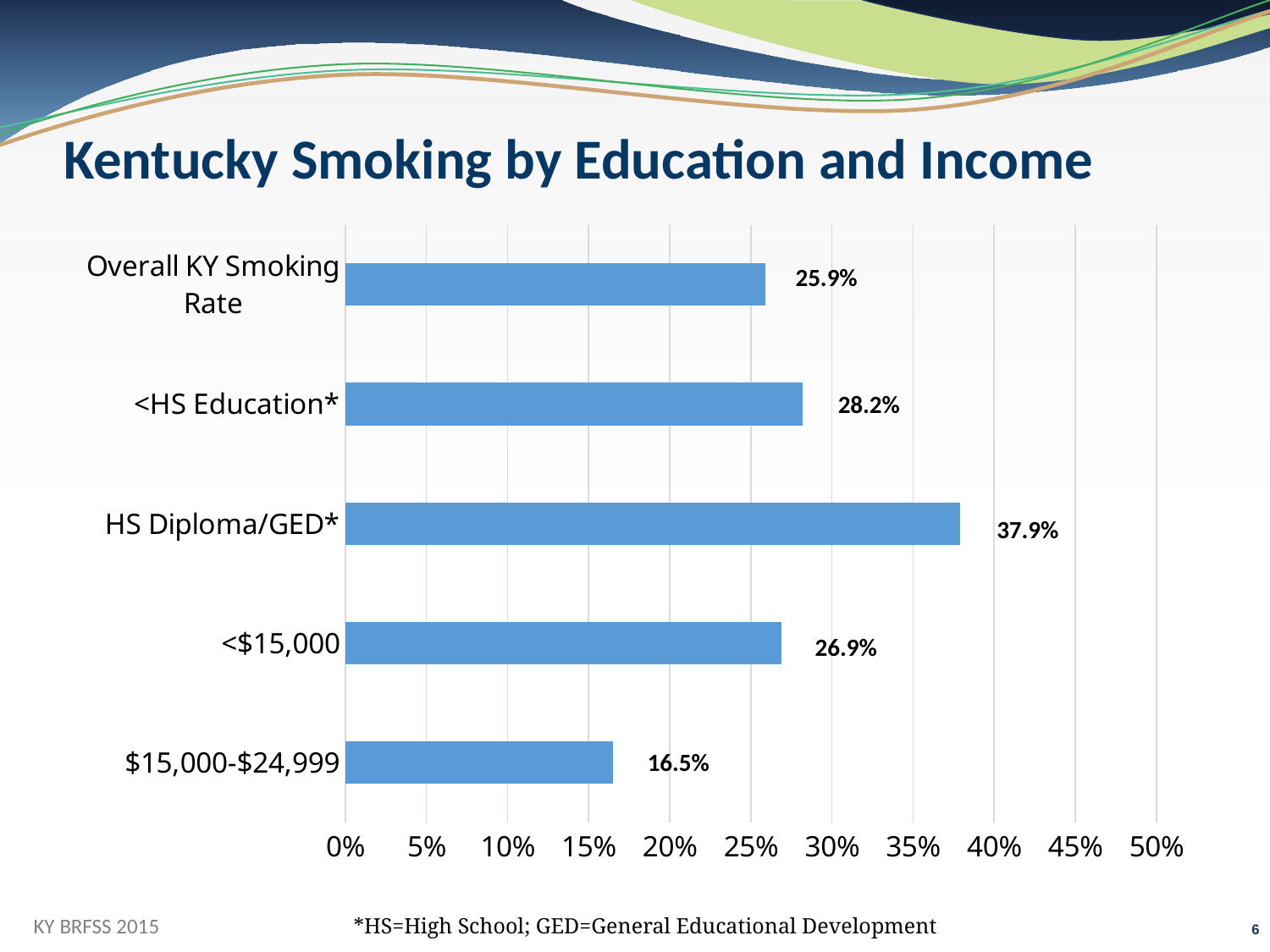
What is the Overall KY Smoking Rate shown on the chart? 25.9% Which is larger, the smoking rate for <HS Education* or for <$15,000? <HS Education* Which category has the lowest smoking rate? $15,000-$24,999 What is the title of the chart? Kentucky Smoking by Education and Income What is the smoking rate for the $15,000-$24,999 income group? 16.5% What is the difference between the smoking rate for HS Diploma/GED* and the Overall KY Smoking Rate? 12.0% Is the value for HS Diploma/GED* greater or less than 35%? greater What kind of chart is shown on the slide? Bar chart How many categories are shown on the chart? 5 What is the smoking rate for HS Diploma/GED*? 37.9% What is the smoking rate for the <$15,000 income group? 26.9% Which category has the highest smoking rate? HS Diploma/GED*